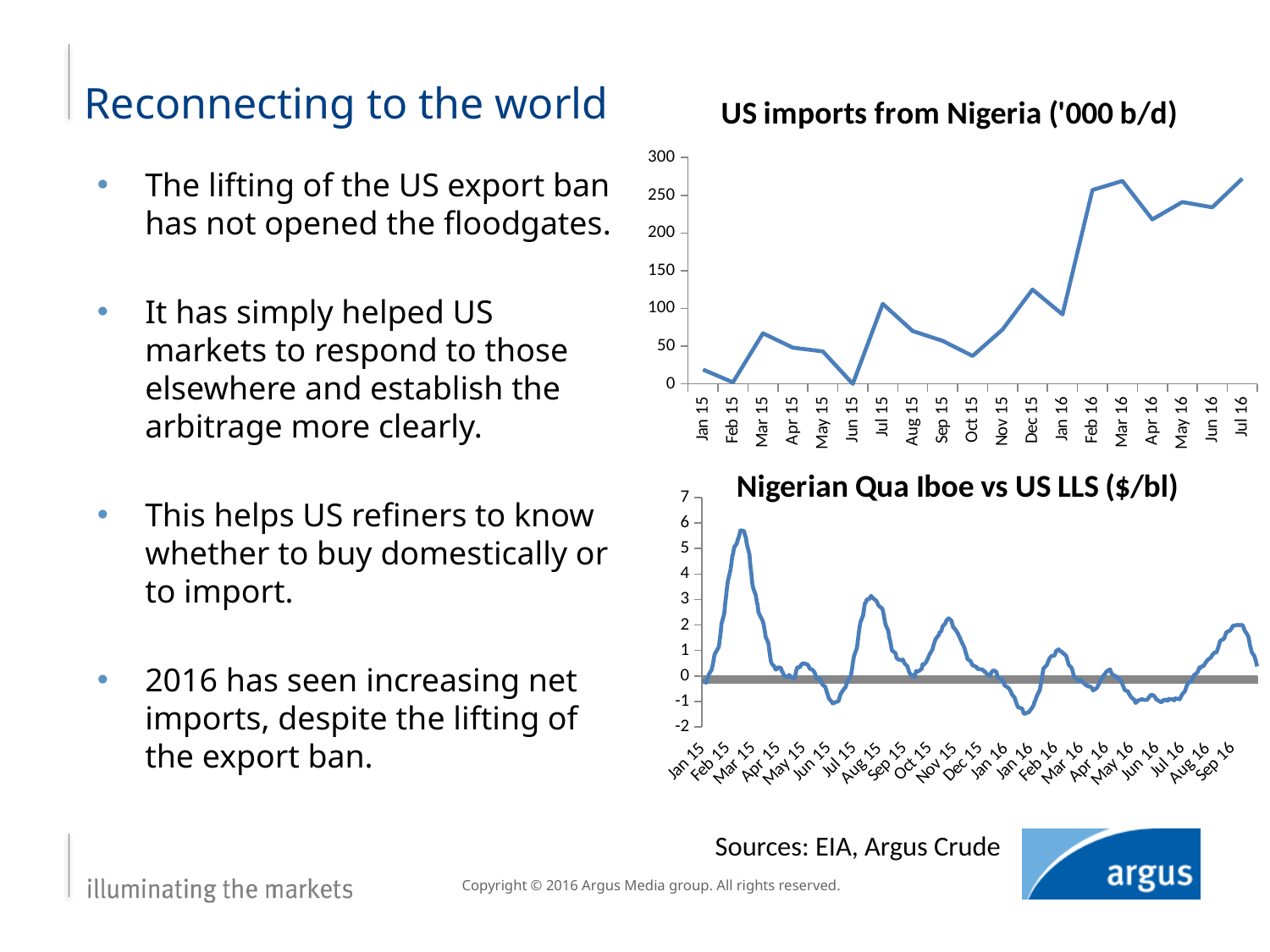
In the 'US imports from Nigeria' chart, which is larger, the value for Jul 16 or the value for Jan 15? Jul 16 In the 'US imports from Nigeria' chart, is the value for Jun 15 greater or less than 50? less In the 'US imports from Nigeria' chart, is the value for Jul 16 greater or less than 250? greater In the 'US imports from Nigeria' chart, do the values overall rise or fall from Jan 15 to Jul 16? rise In the 'US imports from Nigeria' chart, is the value for Dec 15 greater or less than 100? greater How many months are shown on the x axis of the 'US imports from Nigeria' chart? 19 What kind of chart is the 'US imports from Nigeria' chart? line chart What unit is given in the title of the top chart on the slide? '000 b/d What is the title of the bottom chart on the slide? Nigerian Qua Iboe vs US LLS ($/bl) What kind of chart is the 'Nigerian Qua Iboe vs US LLS' chart? line chart